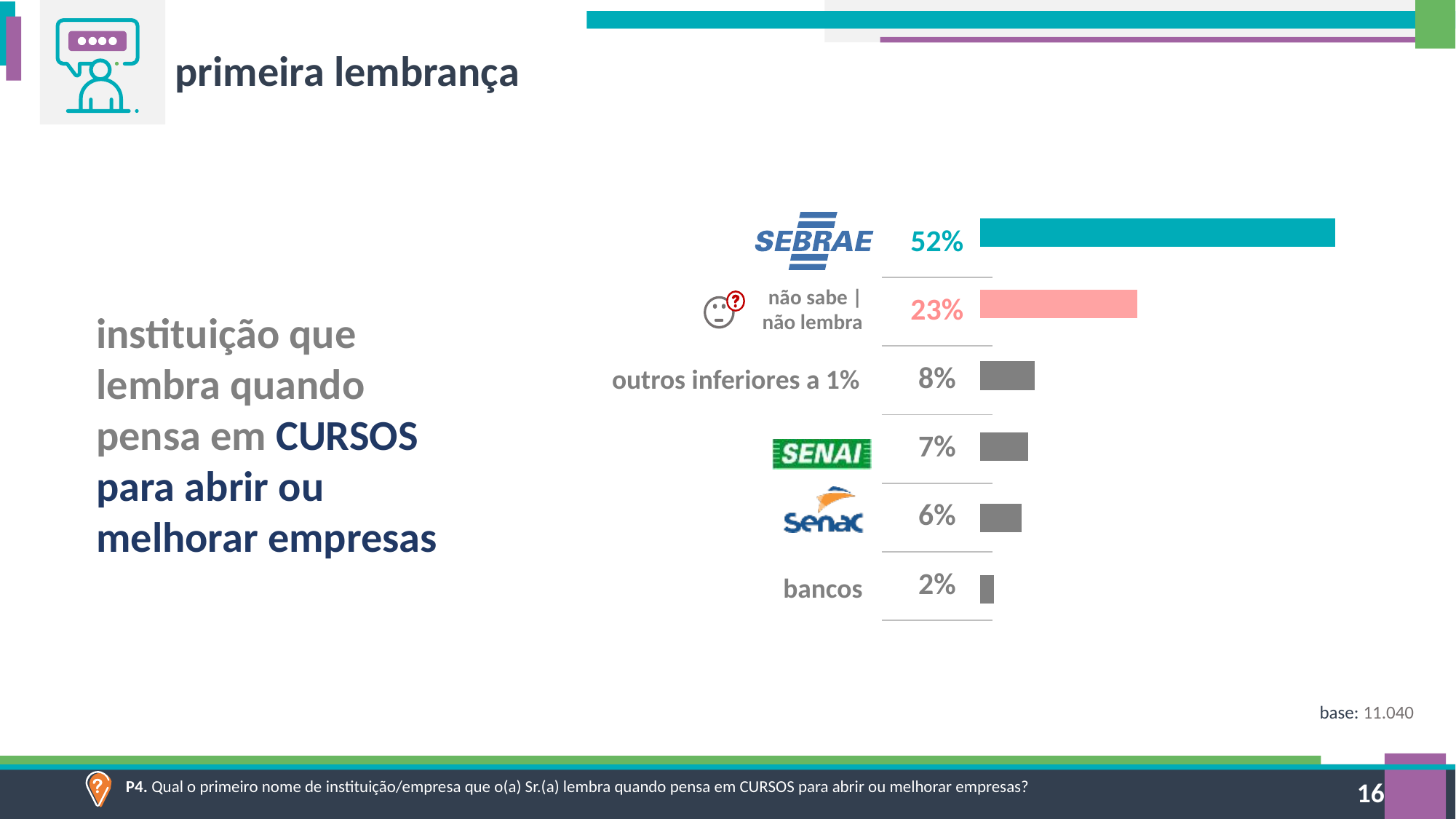
What percentage is shown for 'não sabe | não lembra'? 23% What is the difference between the SEBRAE value and the 'não sabe | não lembra' value? 29% What percentage is shown for SENAI? 7% What kind of chart is shown on the slide? bar chart How many categories are shown in the chart? 6 What percentage is shown for SEBRAE? 52% What percentage is shown for bancos? 2% Which category has the lowest value? bancos Which is larger, the value for SENAI or the value for Senac? SENAI What percentage is shown for Senac? 6% What percentage is shown for 'outros inferiores a 1%'? 8% Which category has the highest value? SEBRAE